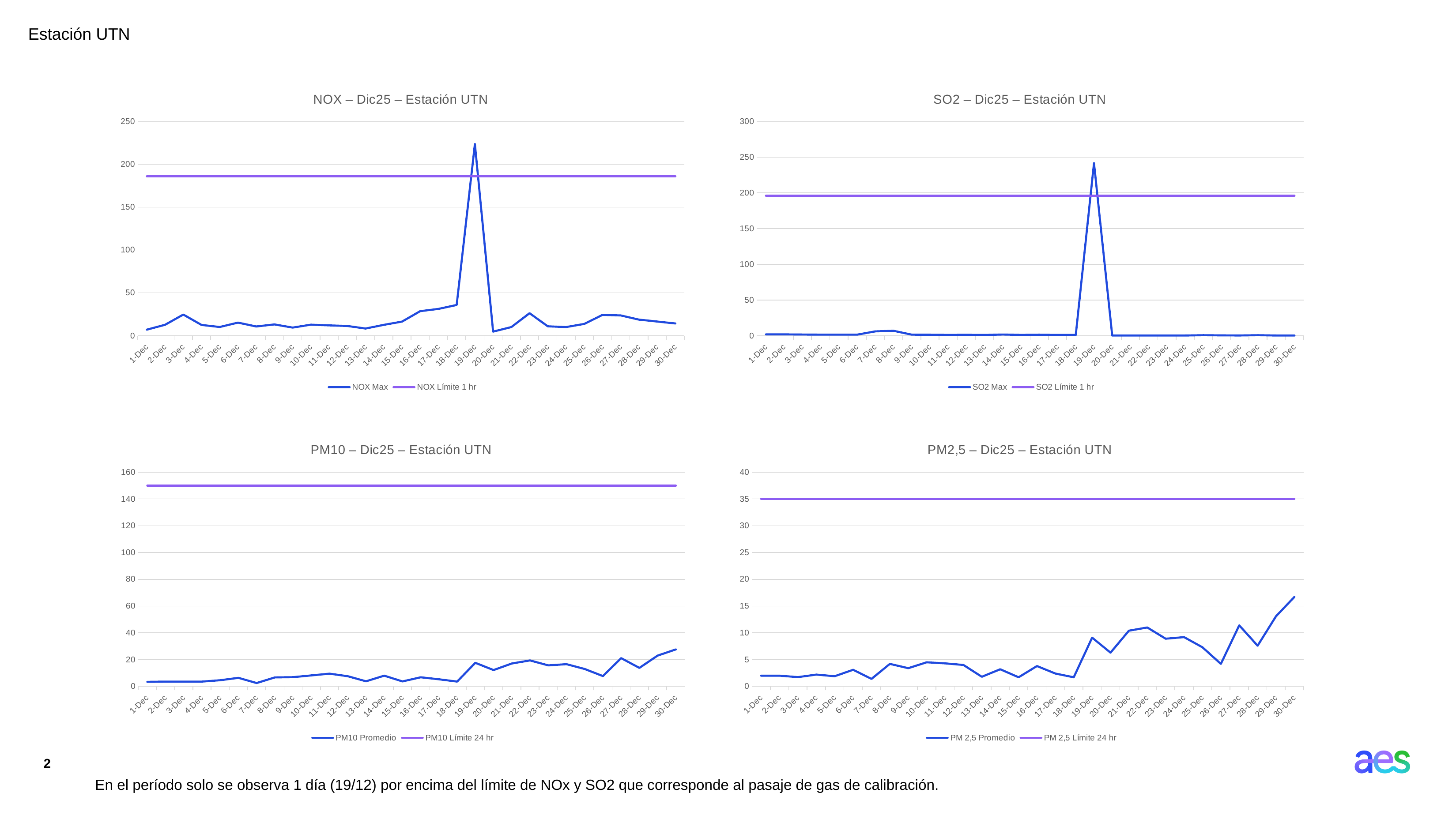
In the PM2,5 – Dic25 – Estación UTN chart, on which date is PM 2,5 Promedio highest? 30-Dec In the PM2,5 – Dic25 – Estación UTN chart, what value does the PM 2,5 Límite 24 hr line sit at? 35 In the NOX – Dic25 – Estación UTN chart, which date has the larger NOX Max value, 19-Dec or 20-Dec? 19-Dec In the PM10 – Dic25 – Estación UTN chart, is the PM10 Promedio value on 30-Dec greater or less than 40? less In the PM2,5 – Dic25 – Estación UTN chart, does PM 2,5 Promedio generally rise or fall from 1-Dec to 30-Dec? rise In the NOX – Dic25 – Estación UTN chart, on which date does NOX Max reach its highest value? 19-Dec What kind of chart is the NOX – Dic25 – Estación UTN chart? line chart In the SO2 – Dic25 – Estación UTN chart, on which date does SO2 Max reach its highest value? 19-Dec In the NOX – Dic25 – Estación UTN chart, is the NOX Max value on 19-Dec greater or less than 200? greater In the SO2 – Dic25 – Estación UTN chart, is the SO2 Max value on 19-Dec greater or less than 200? greater How many series does the legend of the SO2 – Dic25 – Estación UTN chart list? 2 How many dates are plotted along the x axis of the PM10 – Dic25 – Estación UTN chart? 30